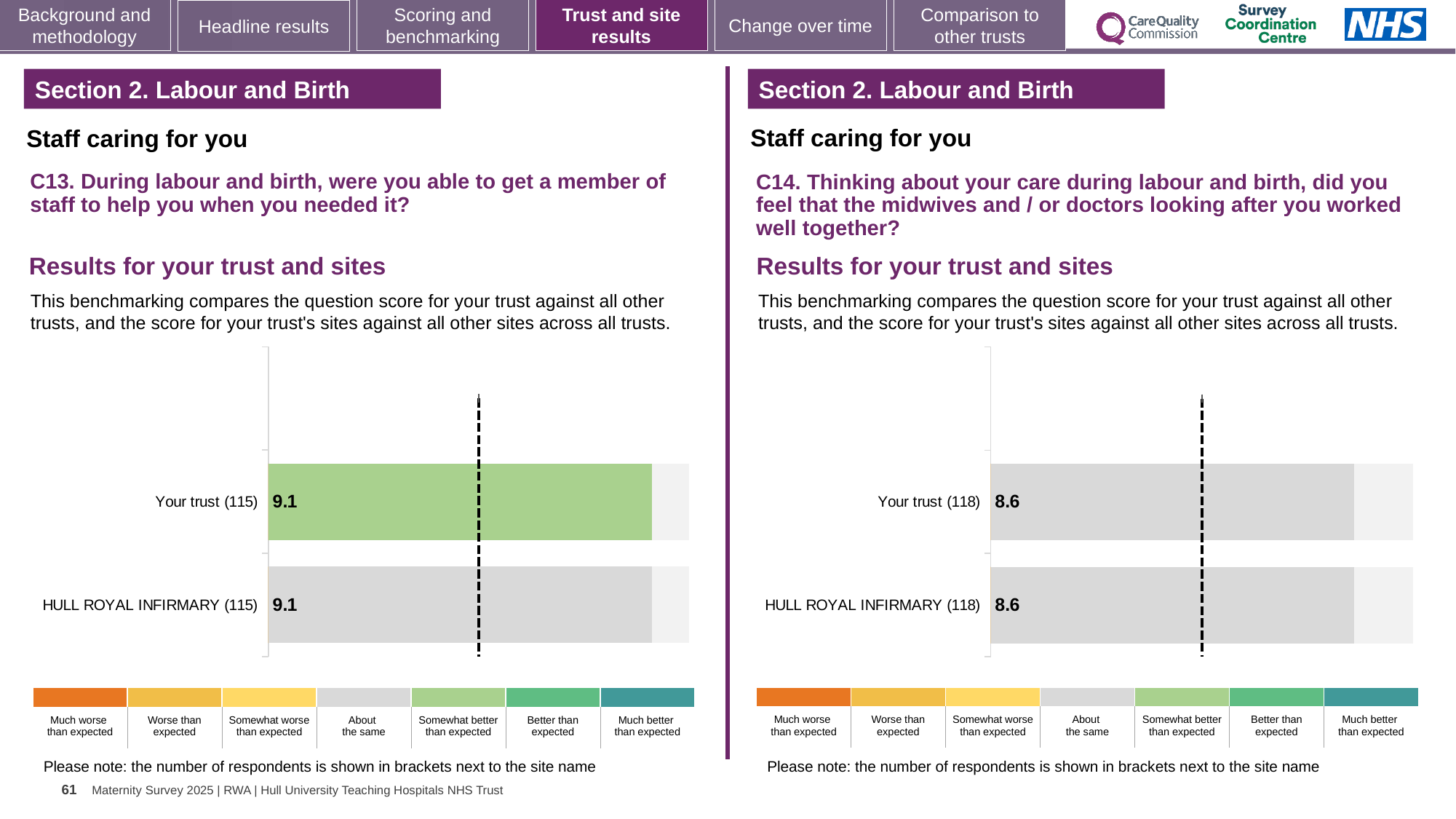
In the C14 chart on the right, what is the score for HULL ROYAL INFIRMARY? 8.6 In the C13 chart on the left, what is the score for HULL ROYAL INFIRMARY? 9.1 In the C13 chart on the left, how many respondents are shown in brackets for Your trust? 115 What kind of chart is used for the C13 results on the left? Bar chart How many bars are plotted in the C14 chart on the right? 2 How many bars are plotted in the C13 chart on the left? 2 In the C13 chart on the left, which benchmark category does the colour of the Your trust bar correspond to in the legend? Somewhat better than expected In the C14 chart on the right, how many respondents are shown in brackets for HULL ROYAL INFIRMARY? 118 In the C14 chart on the right, what is the difference between the Your trust score and the HULL ROYAL INFIRMARY score? 0.0 In the C14 chart on the right, what is the score for Your trust? 8.6 In the C13 chart on the left, what is the difference between the Your trust score and the HULL ROYAL INFIRMARY score? 0.0 In the C13 chart on the left, what is the score for Your trust? 9.1